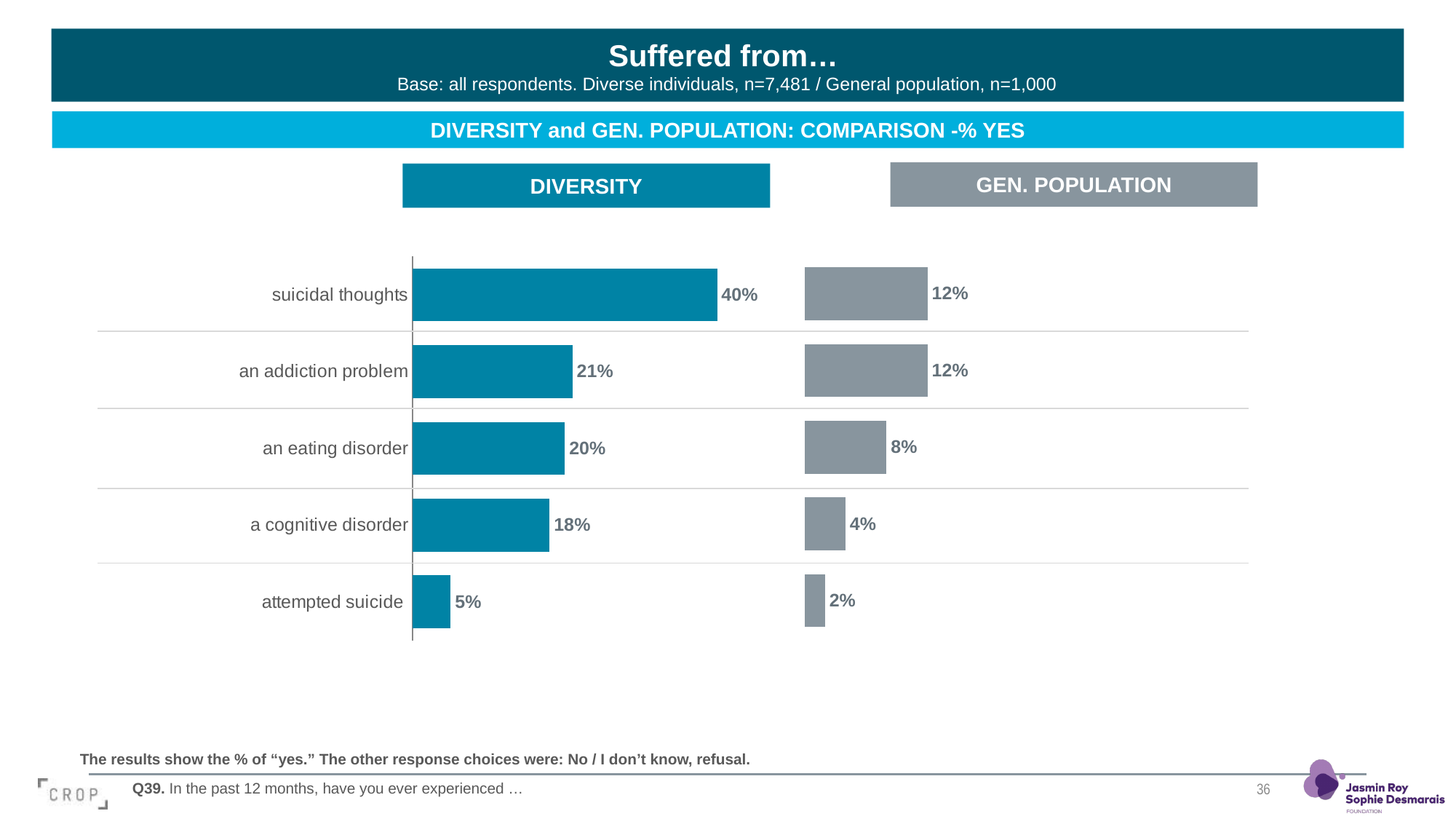
What kind of chart is used on this slide? Bar chart What is the title of the slide's chart section? Suffered from… In the GEN. POPULATION chart, which category has the lowest value? attempted suicide What is the difference between the DIVERSITY and GEN. POPULATION values for suicidal thoughts? 28 percentage points In the DIVERSITY chart, what percentage suffered from suicidal thoughts? 40% In the GEN. POPULATION chart, what is the value for attempted suicide? 2% In the GEN. POPULATION chart, what percentage suffered from a cognitive disorder? 4% Which is larger: the DIVERSITY value for a cognitive disorder or the GEN. POPULATION value for a cognitive disorder? DIVERSITY In the DIVERSITY chart, what is the difference between an addiction problem and an eating disorder? 1 percentage point In the GEN. POPULATION chart, what percentage suffered from an eating disorder? 8% In the DIVERSITY chart, which category has the highest value? suicidal thoughts How many categories are shown in the DIVERSITY chart? 5